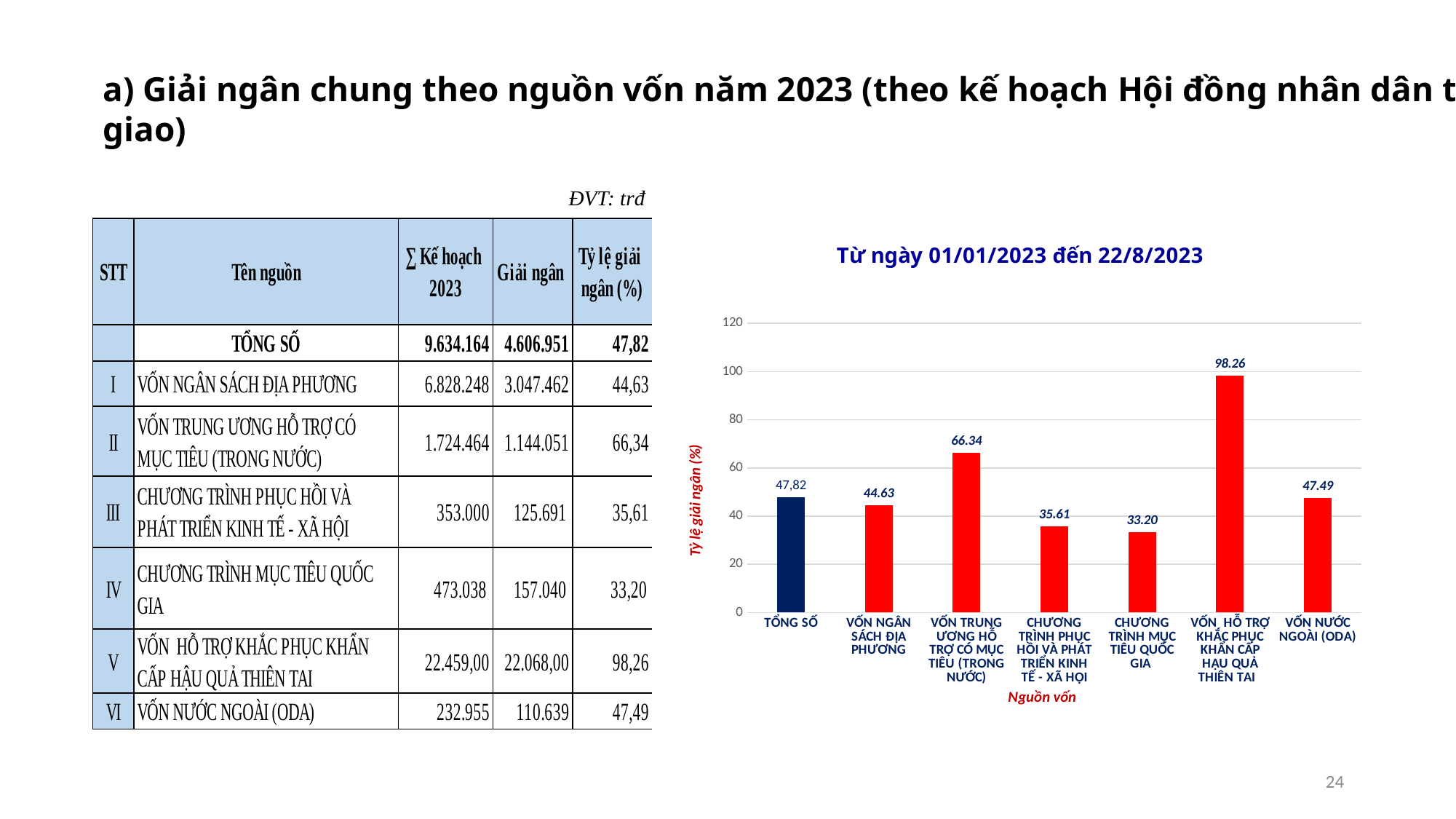
What is the label of the vertical axis in the chart? Tỷ lệ giải ngân (%) Which category has the highest value in the chart? VỐN HỖ TRỢ KHẮC PHỤC KHẨN CẤP HẬU QUẢ THIÊN TAI What type of chart is shown on the slide? bar chart What is the title of the chart? Từ ngày 01/01/2023 đến 22/8/2023 What is the value shown for CHƯƠNG TRÌNH MỤC TIÊU QUỐC GIA in the chart? 33.20 Which category has the lowest value in the chart? CHƯƠNG TRÌNH MỤC TIÊU QUỐC GIA How many bars (categories) are plotted in the chart? 7 What is the value shown for TỔNG SỐ in the chart? 47,82 What is the value shown for VỐN NƯỚC NGOÀI (ODA) in the chart? 47.49 What is the value shown for VỐN TRUNG ƯƠNG HỖ TRỢ CÓ MỤC TIÊU (TRONG NƯỚC) in the chart? 66.34 Which is larger in the chart: the value for VỐN NGÂN SÁCH ĐỊA PHƯƠNG or the value for VỐN TRUNG ƯƠNG HỖ TRỢ CÓ MỤC TIÊU (TRONG NƯỚC)? VỐN TRUNG ƯƠNG HỖ TRỢ CÓ MỤC TIÊU (TRONG NƯỚC) What is the difference between the values for VỐN HỖ TRỢ KHẮC PHỤC KHẨN CẤP HẬU QUẢ THIÊN TAI and CHƯƠNG TRÌNH PHỤC HỒI VÀ PHÁT TRIỂN KINH TẾ - XÃ HỘI? 62.65